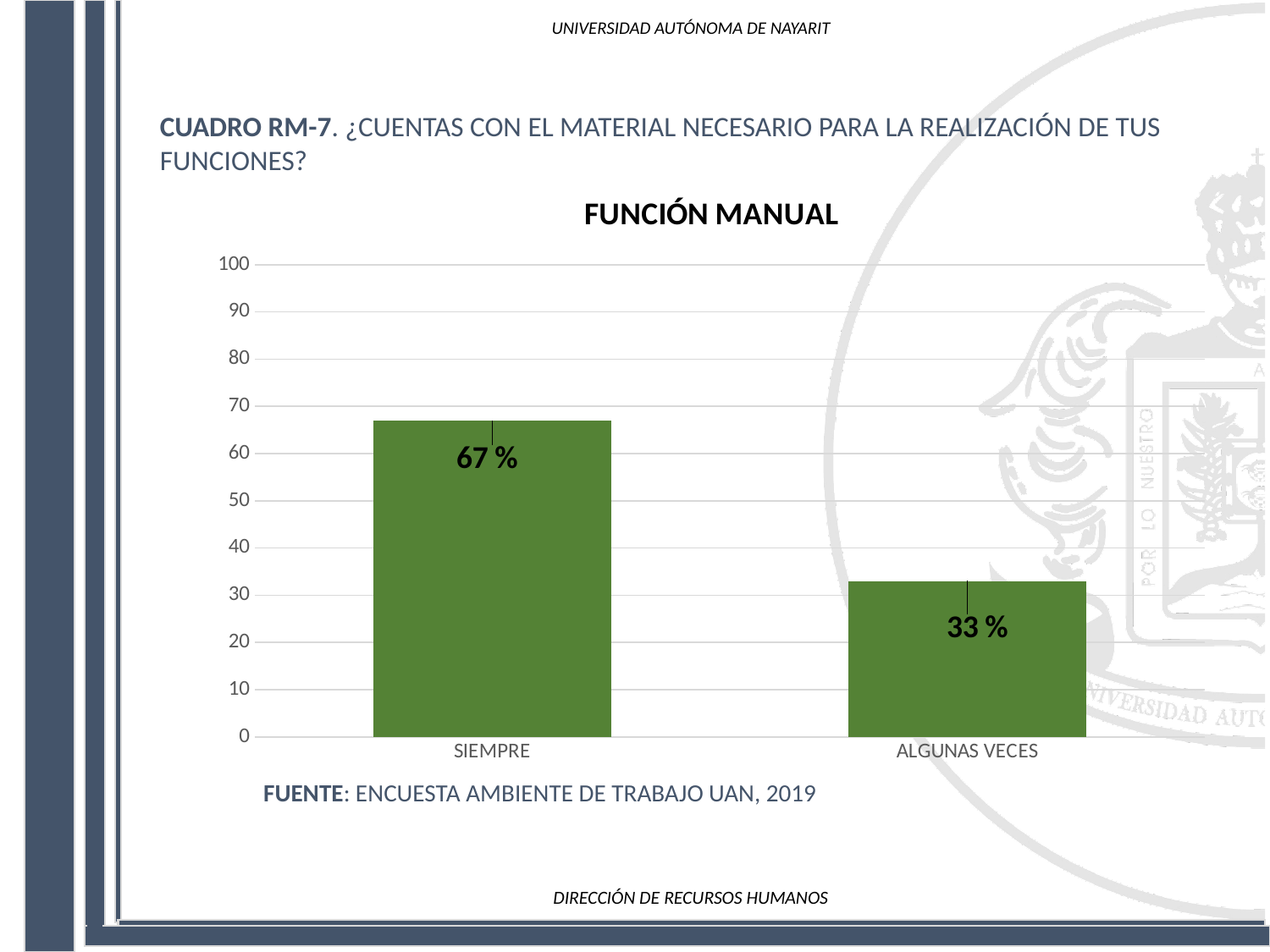
Which category has the lowest value? ALGUNAS VECES Is the value for SIEMPRE greater or less than 60? greater How many categories are shown on the x axis? 2 What kind of chart is shown on the slide? bar chart What is the value for ALGUNAS VECES? 33 % What is the value for SIEMPRE? 67 % What is the difference between the values for SIEMPRE and ALGUNAS VECES? 34 % Which is larger, the value for SIEMPRE or the value for ALGUNAS VECES? SIEMPRE Which category has the highest value? SIEMPRE What is the highest value shown on the y axis? 100 Is the value for ALGUNAS VECES greater or less than 40? less What is the title of the chart? FUNCIÓN MANUAL